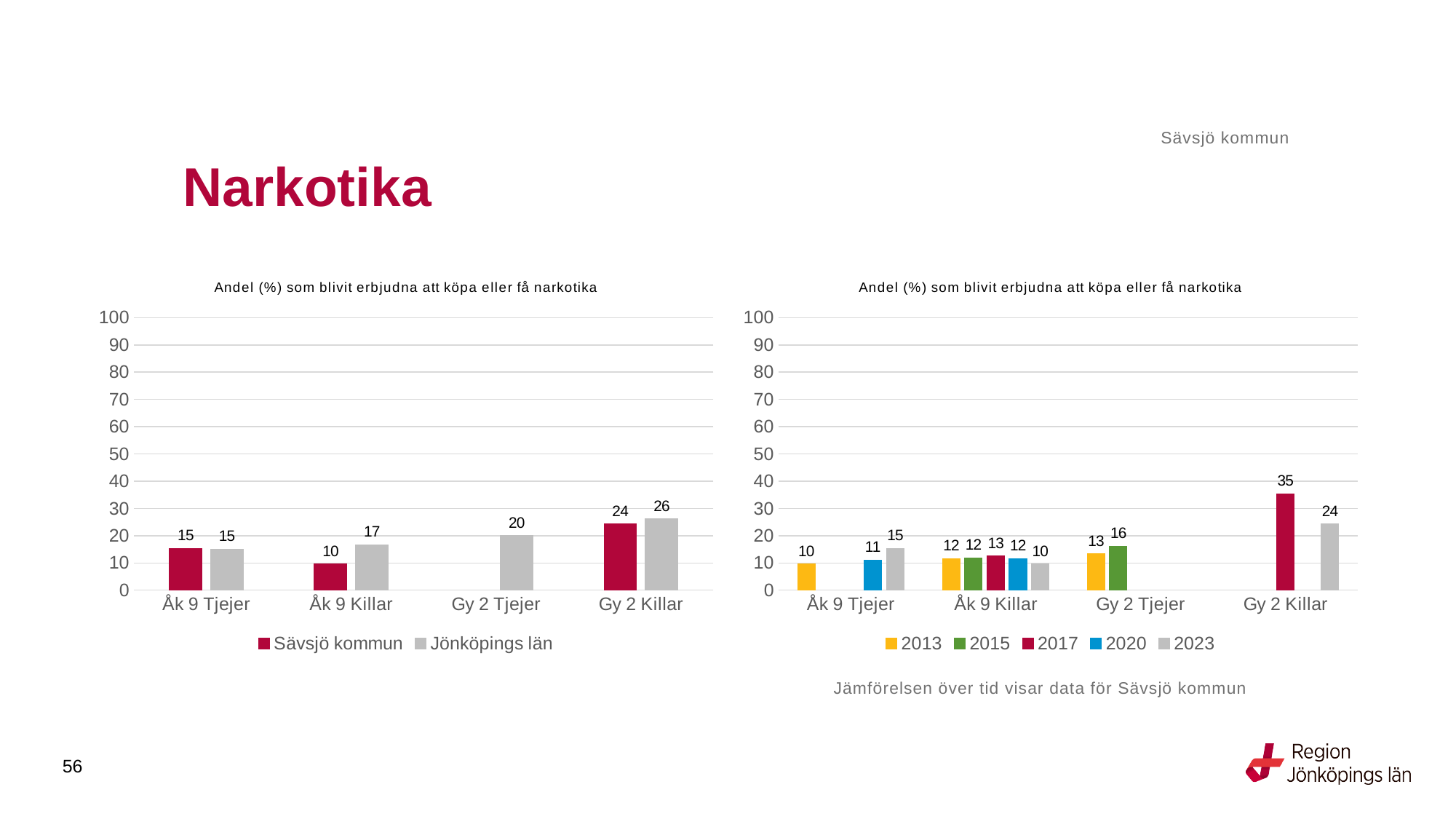
In the left chart, what is the value for Sävsjö kommun for Åk 9 Killar? 10 What kind of chart is the left chart? Bar chart In the right chart, what is the difference between 2015 and 2013 for Gy 2 Tjejer? 3 In the right chart, what is the value for 2017 for Gy 2 Killar? 35 In the right chart, what is the value for 2023 for Åk 9 Tjejer? 15 In the left chart, which category has the highest value for Sävsjö kommun? Gy 2 Killar In the left chart, what is the difference between Jönköpings län and Sävsjö kommun for Åk 9 Killar? 7 In the left chart, how many series does the legend list? 2 In the right chart, which is larger for Gy 2 Killar: 2017 or 2023? 2017 In the right chart, how many categories are shown on the x axis? 4 In the left chart, what is the value for Jönköpings län for Gy 2 Killar? 26 In the right chart, how many series does the legend list? 5